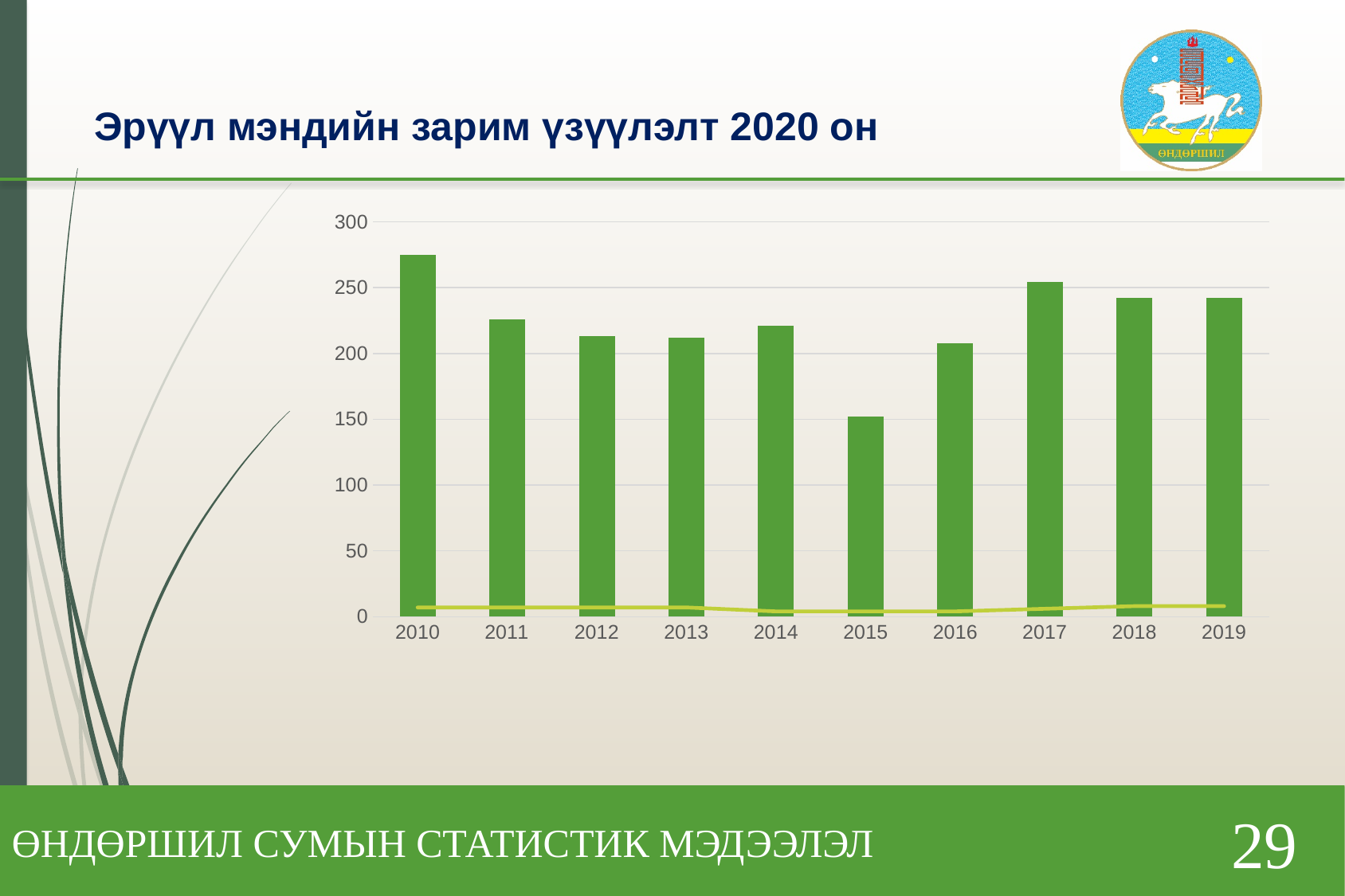
Is the bar for 2015 greater or less than 200? less Do the bars rise or fall from 2010 to 2015? fall Which bar is taller, 2010 or 2011? 2010 Is the bar for 2011 greater or less than 200? greater Which year has the highest bar in the chart? 2010 How many years are shown on the x axis of the chart? 10 Is the bar for 2010 greater or less than 250? greater Which year has the lowest bar in the chart? 2015 What is the first year shown on the x axis of the chart? 2010 What kind of chart is shown on the slide? combination bar and line chart Which bar is taller, 2015 or 2016? 2016